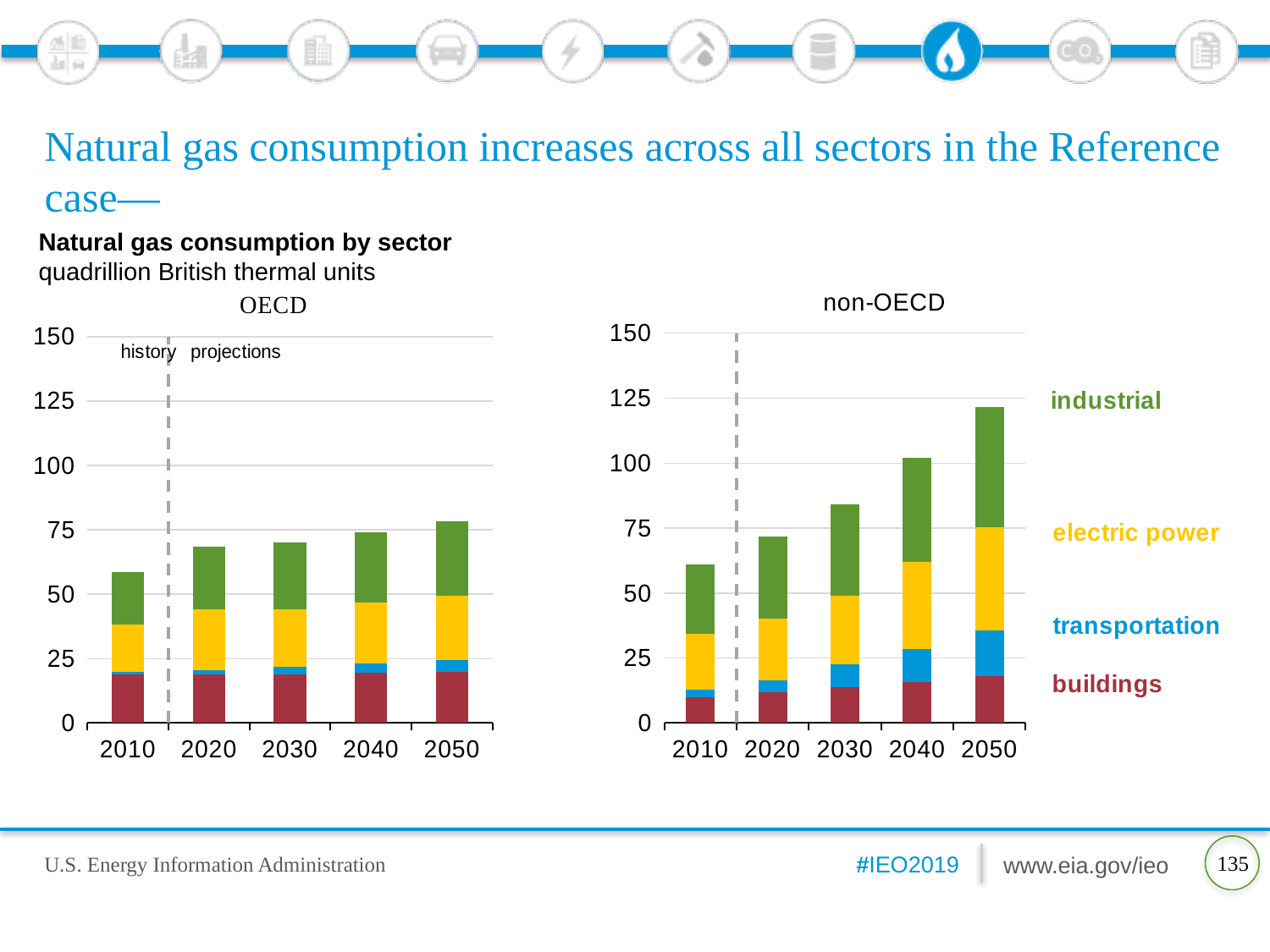
Which colour represents the industrial sector in the charts? green How many years are shown on the x axis of the non-OECD chart? 5 What kind of chart is the OECD chart? stacked bar chart Which is larger in 2050: the total for OECD or the total for non-OECD? non-OECD In the non-OECD chart, is the total for 2030 greater or less than 75? greater In the OECD chart, is the total for 2010 greater or less than 50? greater In the non-OECD chart, do total values rise or fall from 2010 to 2050? rise In the non-OECD chart, is the total for 2050 greater or less than 100? greater In the non-OECD chart, which year has the highest total natural gas consumption? 2050 How many sectors does the legend list? 4 In the OECD chart, which year has the lowest total natural gas consumption? 2010